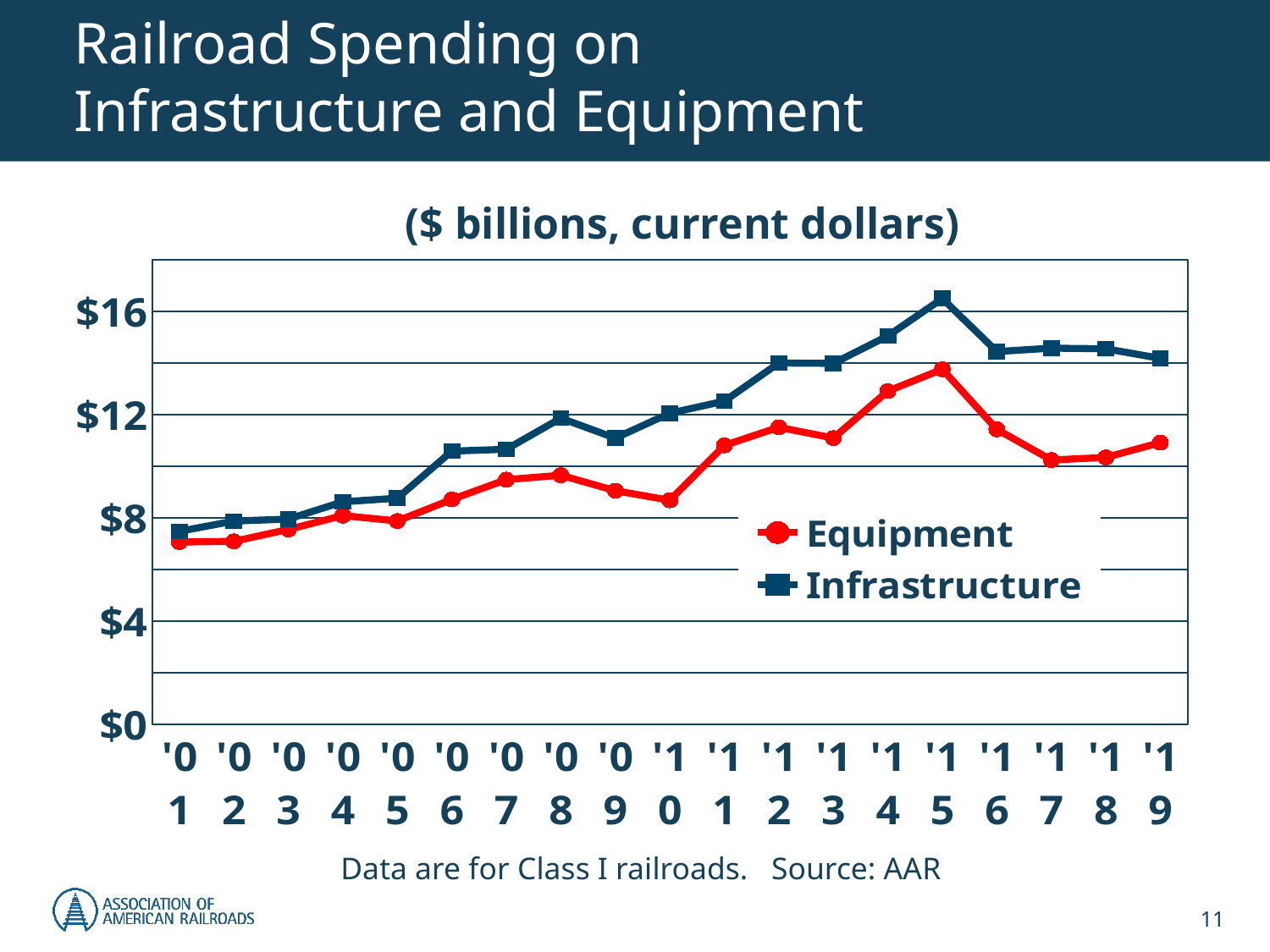
What units does the chart subtitle say the values are in? $ billions, current dollars Does Infrastructure spending generally rise or fall from '01 to '15? rise Is the Equipment value for '01 greater or less than $8? less In which year is Infrastructure spending highest? '15 What kind of chart is shown on the slide? line chart How many series does the legend list? 2 In which year is Infrastructure spending lowest? '01 Is the Infrastructure value for '15 greater or less than $16? greater How many years are plotted along the x axis? 19 In '19, which series has the larger value, Equipment or Infrastructure? Infrastructure In which year is Equipment spending highest? '15 Is the Infrastructure value for '12 greater or less than $12? greater